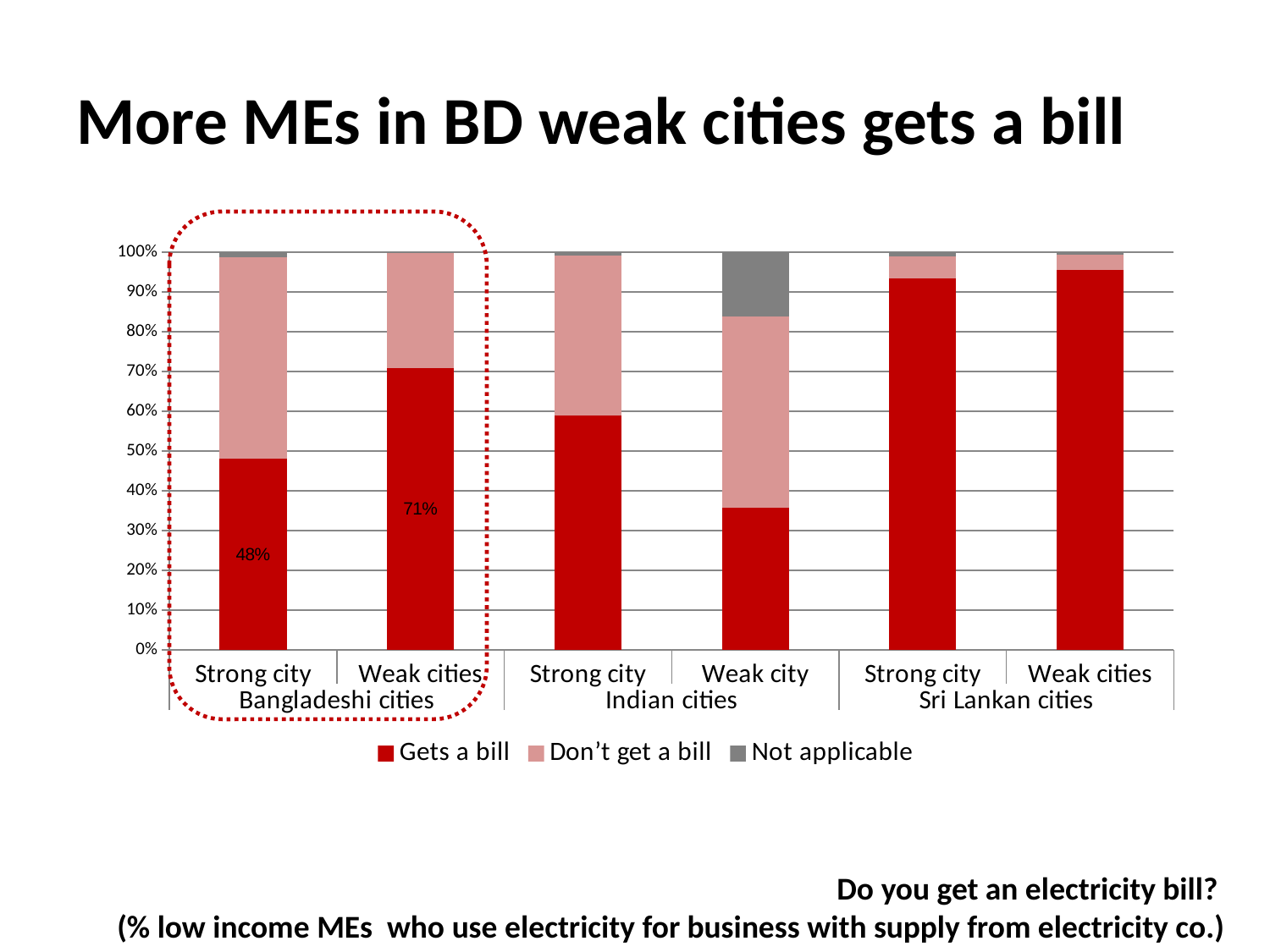
What percentage of MEs in the Bangladeshi weak cities get a bill? 71% By how many percentage points does the 'Gets a bill' share in Bangladeshi weak cities exceed that in the Bangladeshi strong city? 23 percentage points How many series does the legend list? 3 What percentage of MEs in the Bangladeshi strong city get a bill? 48% What kind of chart is shown on the slide? Stacked bar chart Is the 'Gets a bill' share for the Indian weak city greater or less than 40%? less How many bars are shown in the chart? 6 Which has a larger 'Gets a bill' share: the Bangladeshi strong city or the Bangladeshi weak cities? Weak cities Which city category has the largest 'Not applicable' segment? Indian weak city Which city category has the lowest 'Gets a bill' share? Indian weak city Is the 'Gets a bill' share for the Indian strong city greater or less than 50%? greater Is the 'Gets a bill' share for the Sri Lankan strong city greater or less than 90%? greater